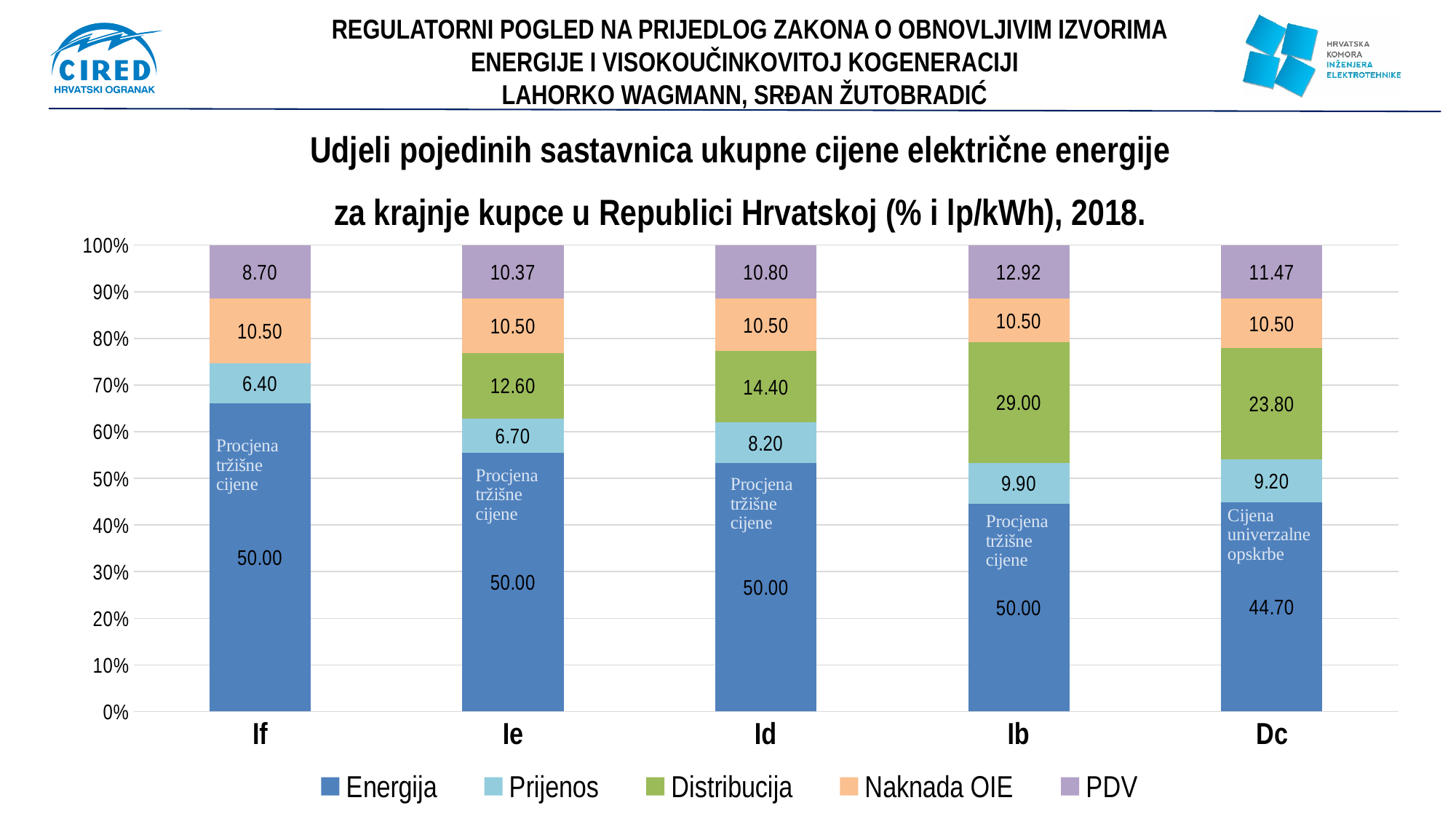
How many series does the legend list? 5 What kind of chart is shown on the slide? Stacked bar chart What is the difference between the Distribucija values for Ib and Dc? 5.20 What is the Prijenos value for category Id? 8.20 How many categories are shown on the x axis? 5 What is the Distribucija value for category Ib? 29.00 What is the sum of all labelled segment values for category Ib? 112.32 Which is larger, the PDV value for Ie or the PDV value for Id? Id What is the Energija value for category Dc? 44.70 Which category has the highest PDV value? Ib What is the PDV value for category If? 8.70 Which category has the lowest Prijenos value? If